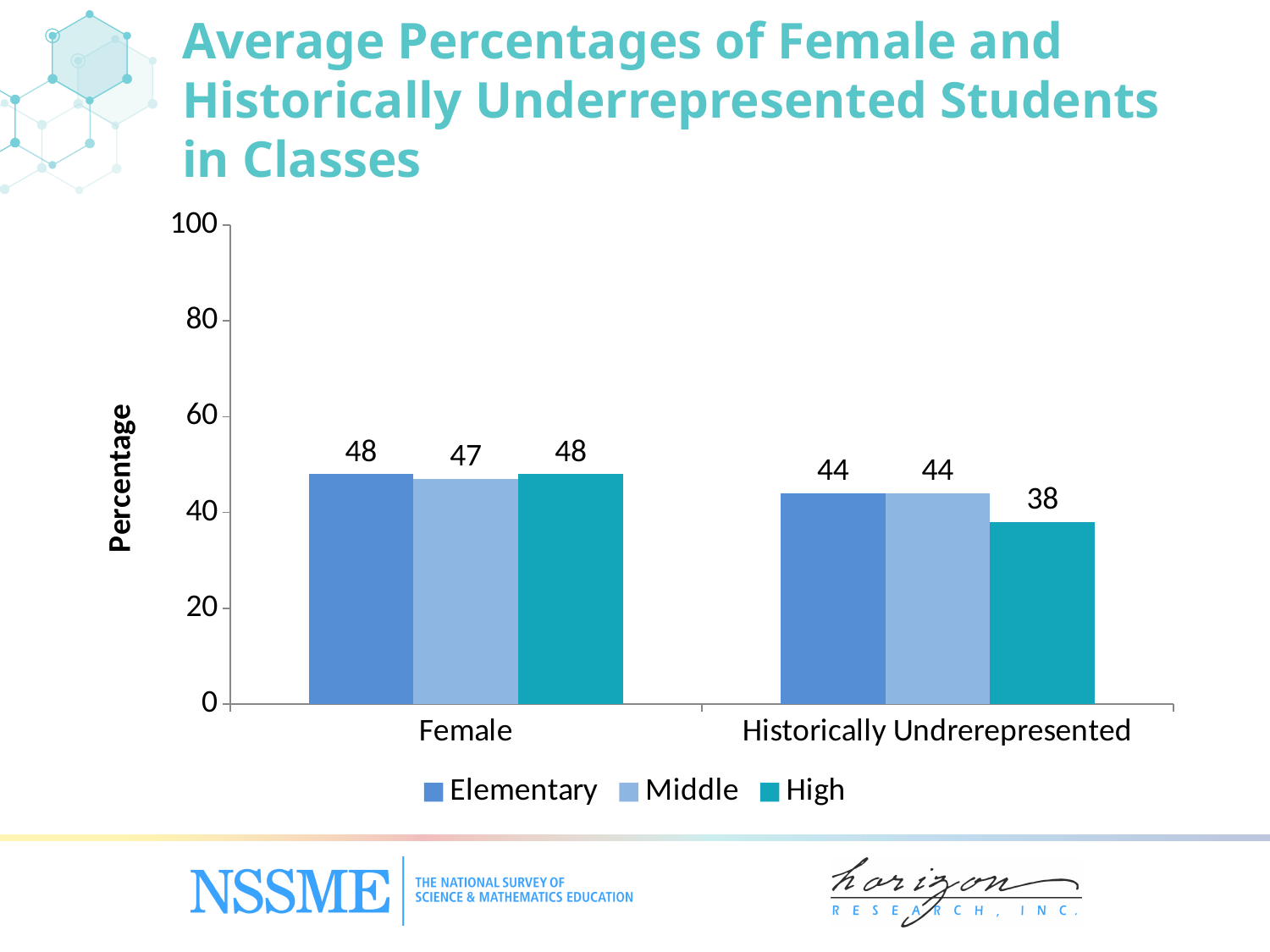
What is the value for Elementary in the Historically Underrepresented category? 44 Which series has the lowest value in the Historically Underrepresented category? High How many categories are shown on the x axis? 2 Is the value for High in the Historically Underrepresented category greater or less than 40? less What kind of chart is shown on the slide? bar chart What is the label of the y axis? Percentage How many series does the legend list? 3 What is the value for High in the Historically Underrepresented category? 38 What is the difference between the Elementary value for Female and the Elementary value for Historically Underrepresented? 4 What is the difference between the High value for Female and the High value for Historically Underrepresented? 10 What is the value for Middle in the Female category? 47 Which is larger: the Middle value for Female or the Middle value for Historically Underrepresented? Female